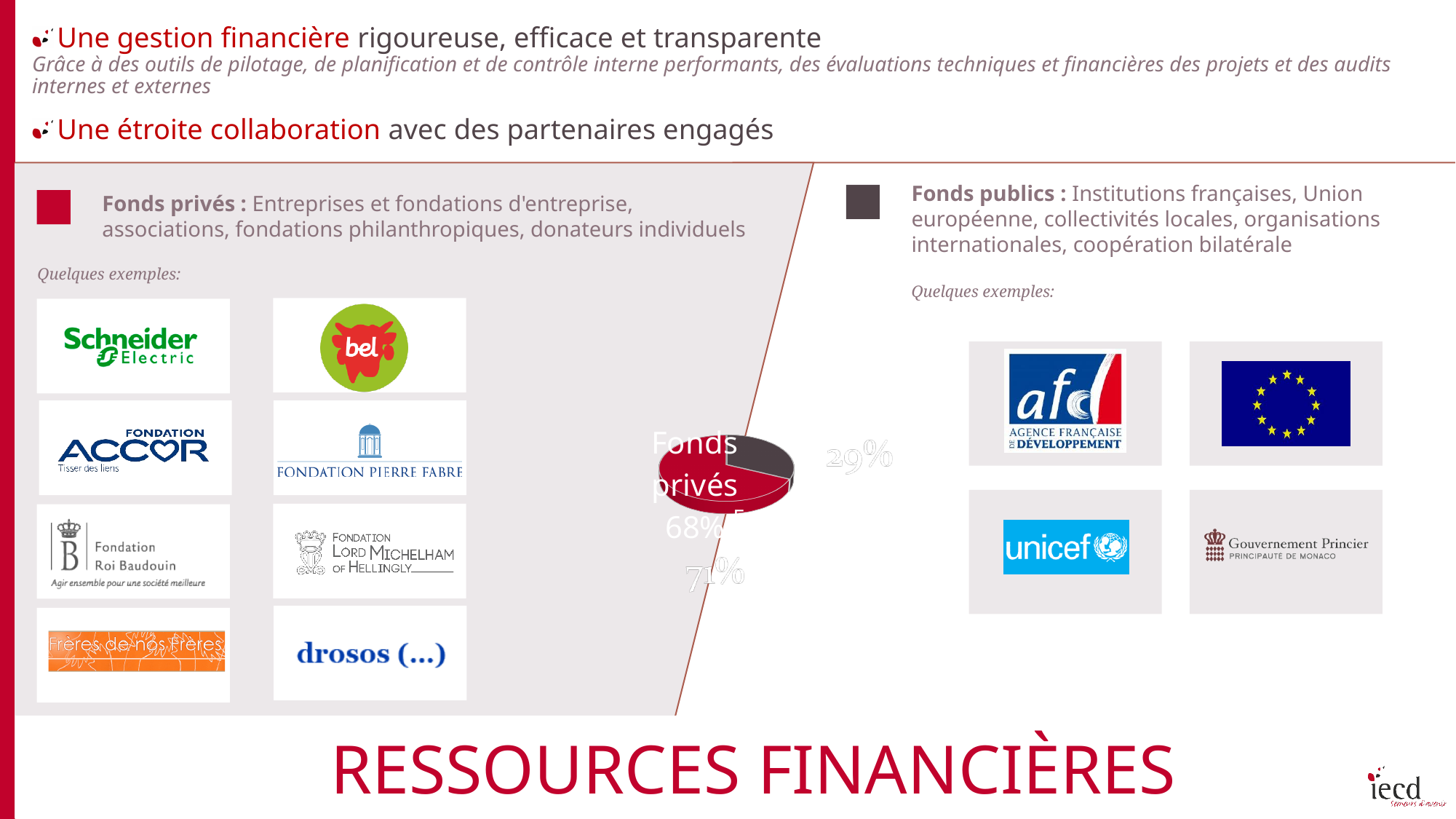
How many slices does the pie chart have? 2 Which slice of the pie chart is larger, the red one or the dark grey one? the red one What colour is the 'Fonds privés' slice of the pie chart? red Which category does the largest slice of the pie chart represent? Fonds privés Is the share of the red 'Fonds privés' slice in the pie chart greater or less than 50%? greater What kind of chart is shown in the middle of the slide? pie chart What percentage is shown next to the dark grey slice of the pie chart? 29% Is the share of the dark grey slice in the pie chart greater or less than 50%? less